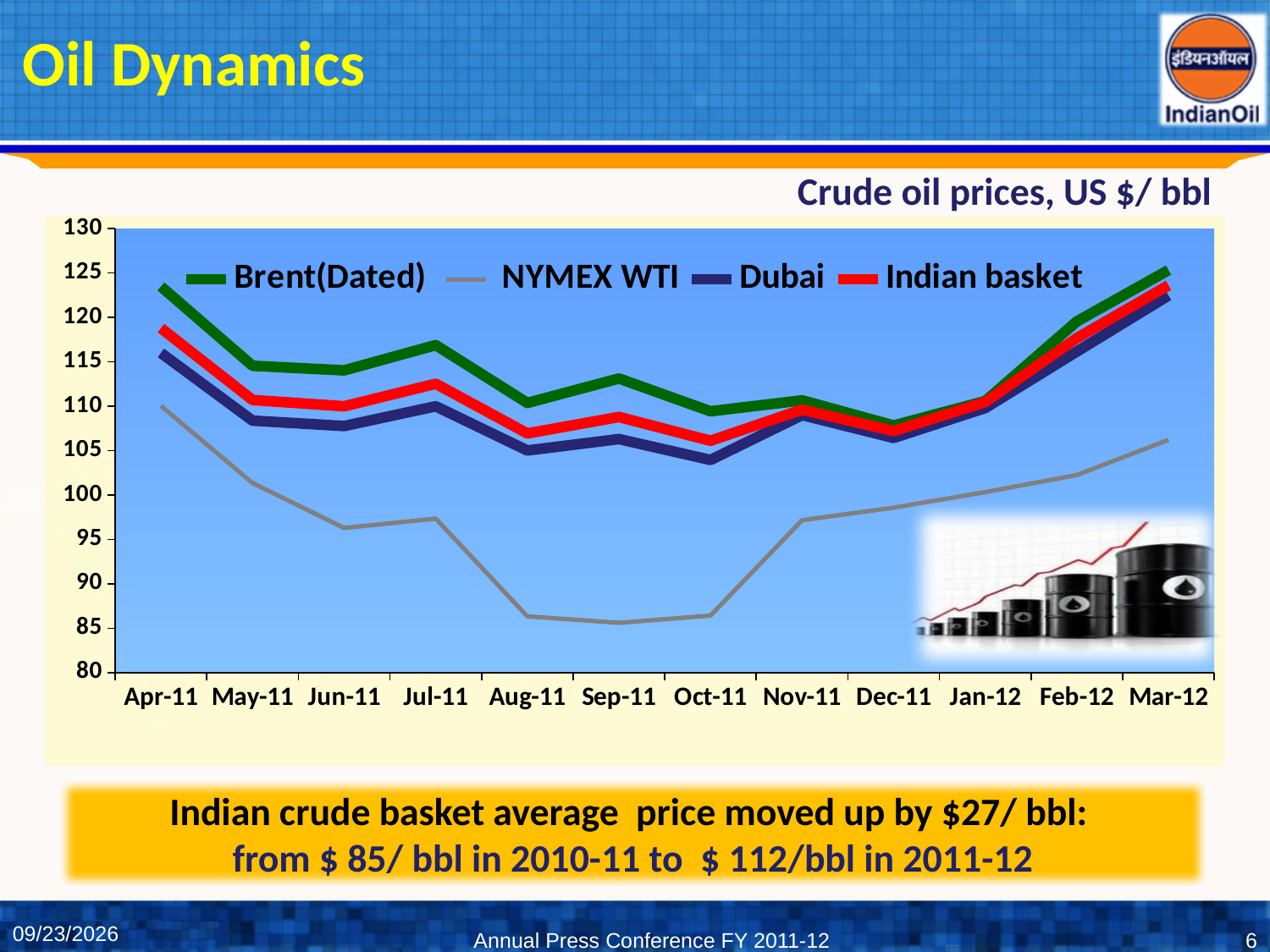
Does the NYMEX WTI line rise or fall from Sep-11 to Mar-12? rise Is the value for Brent(Dated) in Apr-11 greater or less than 120? greater Which series has the highest value in Mar-12? Brent(Dated) Is the value for Indian basket in Mar-12 greater or less than 120? greater What is the title of the chart? Crude oil prices, US $/ bbl What kind of chart is shown on the slide? line chart Is the value for NYMEX WTI in Sep-11 greater or less than 90? less How many series does the legend list? 4 Which series has the lowest values across the whole period? NYMEX WTI In Aug-11, which is larger: Brent(Dated) or NYMEX WTI? Brent(Dated) How many months are plotted along the x axis? 12